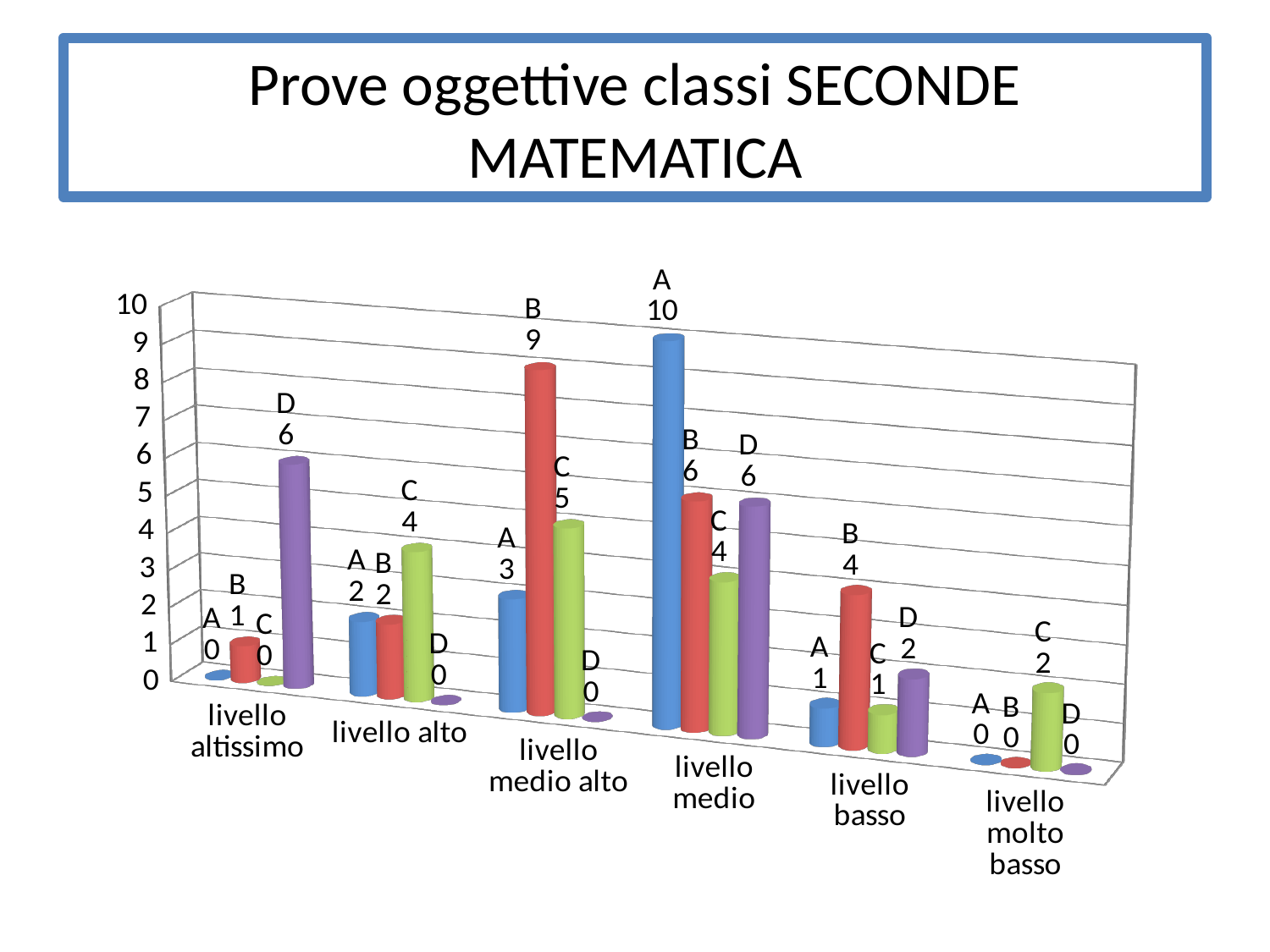
How many categories are shown on the x axis? 6 What is the difference between series A and series C in the 'livello medio' category? 6 Which is larger in the 'livello basso' category: series B or series D? B Which series has the highest value in the 'livello medio alto' category? B What is the value for series B in the 'livello medio alto' category? 9 What kind of chart is shown on the slide? bar chart What is the total of the four series values in the 'livello altissimo' category? 7 Which series has the lowest value in the 'livello alto' category? D What is the value for series C in the 'livello molto basso' category? 2 What is the value for series A in the 'livello medio' category? 10 What is the title of the slide containing the chart? Prove oggettive classi SECONDE MATEMATICA What is the value for series D in the 'livello altissimo' category? 6